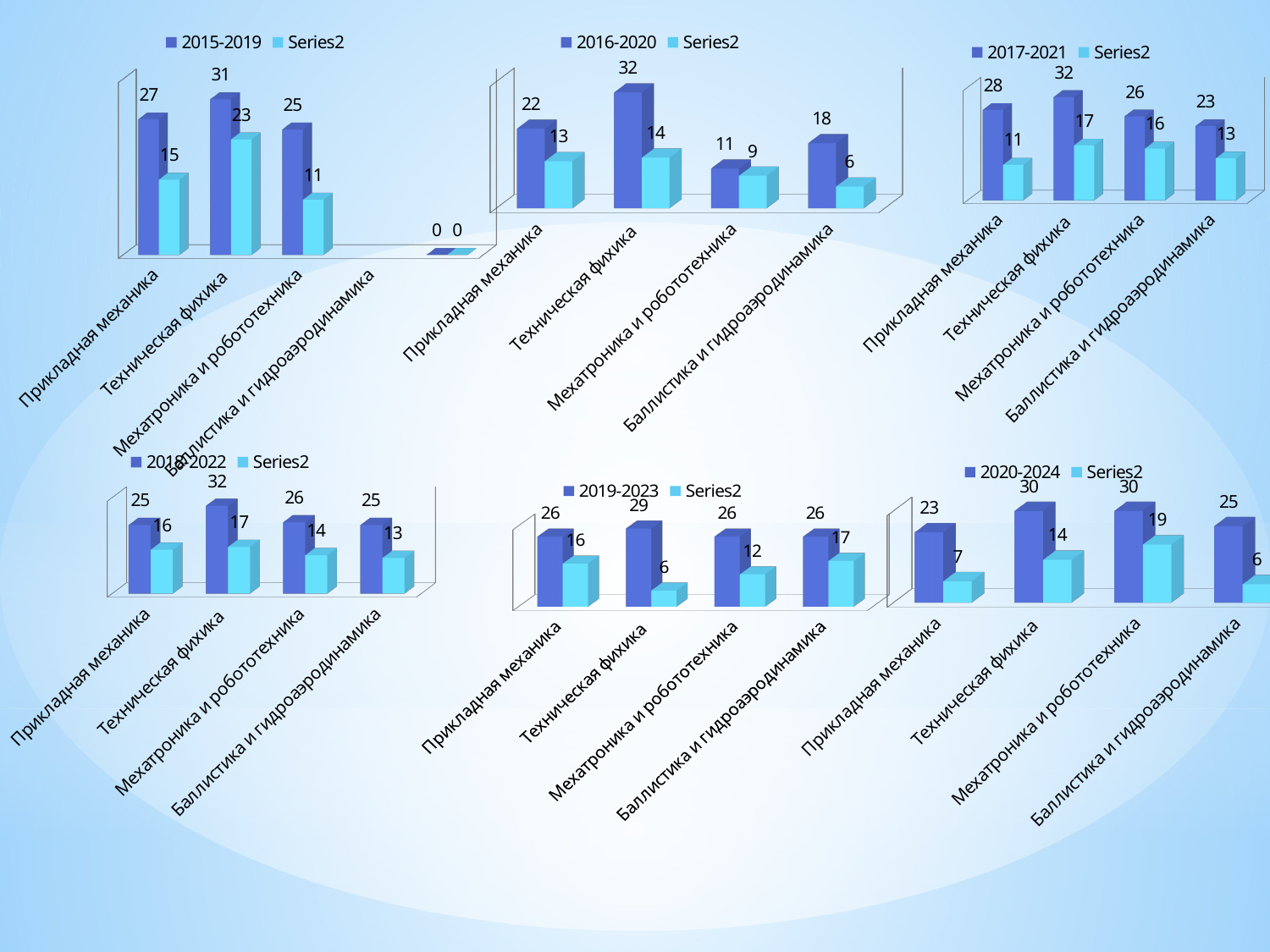
In the chart whose legend starts with 2016-2020, what is the Series2 value for Баллистика и гидроаэродинамика? 6 How many charts are shown on the slide? 6 In the chart whose legend starts with 2017-2021, which category has the highest 2017-2021 value? Техническая фихика In the chart whose legend starts with 2016-2020, which category has the lowest 2016-2020 value? Мехатроника и робототехника In the chart whose legend starts with 2018-2022, what is the difference between the 2018-2022 value and the Series2 value for Прикладная механика? 9 In the chart whose legend starts with 2019-2023, which is larger: the Series2 value for Техническая фихика or the Series2 value for Баллистика и гидроаэродинамика? Баллистика и гидроаэродинамика In the chart whose legend starts with 2020-2024, what is the Series2 value for Мехатроника и робототехника? 19 In the chart whose legend starts with 2015-2019, what is the 2015-2019 value for Техническая фихика? 31 How many categories are shown on the x axis of the chart whose legend starts with 2017-2021? 4 What kind of chart is the one whose legend starts with 2015-2019? Bar chart How many series does the legend list in the chart whose legend starts with 2020-2024? 2